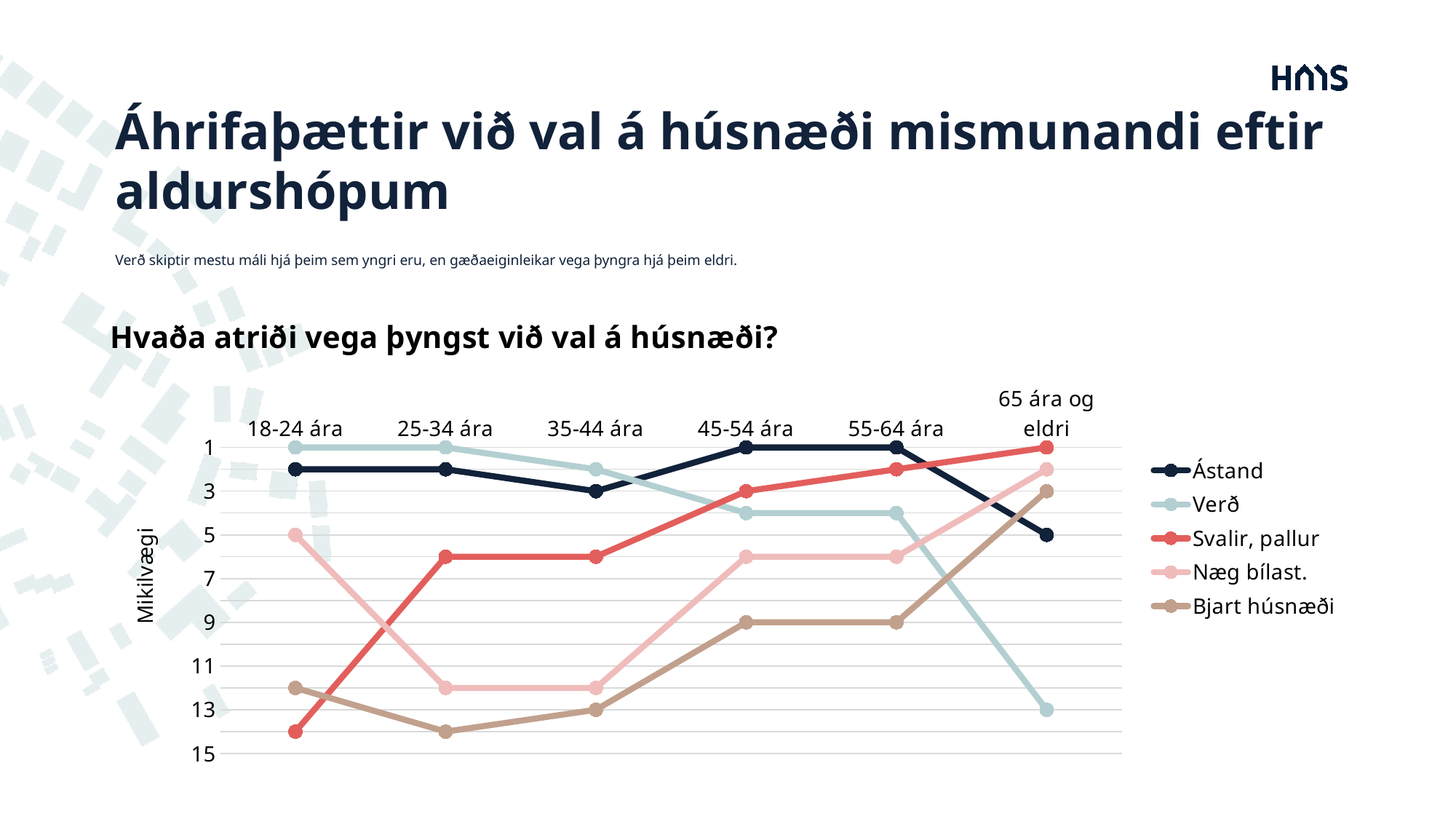
What is the plotted value for Svalir, pallur in the 65 ára og eldri group? 1 What type of chart is shown on the slide? line chart What is the plotted value for Verð in the 65 ára og eldri group? 13 What is the plotted value for Næg bílast. in the 18-24 ára group? 5 What is the label on the y axis? Mikilvægi What is the plotted value for Ástand in the 65 ára og eldri group? 5 What is the difference between the Verð value for 65 ára og eldri and the Verð value for 18-24 ára? 12 What is the plotted value for Verð in the 18-24 ára group? 1 How many age groups are plotted along the x axis? 6 In the 65 ára og eldri group, which series has the larger plotted value, Verð or Ástand? Verð How many series does the legend list? 5 What is the plotted value for Bjart húsnæði in the 45-54 ára group? 9